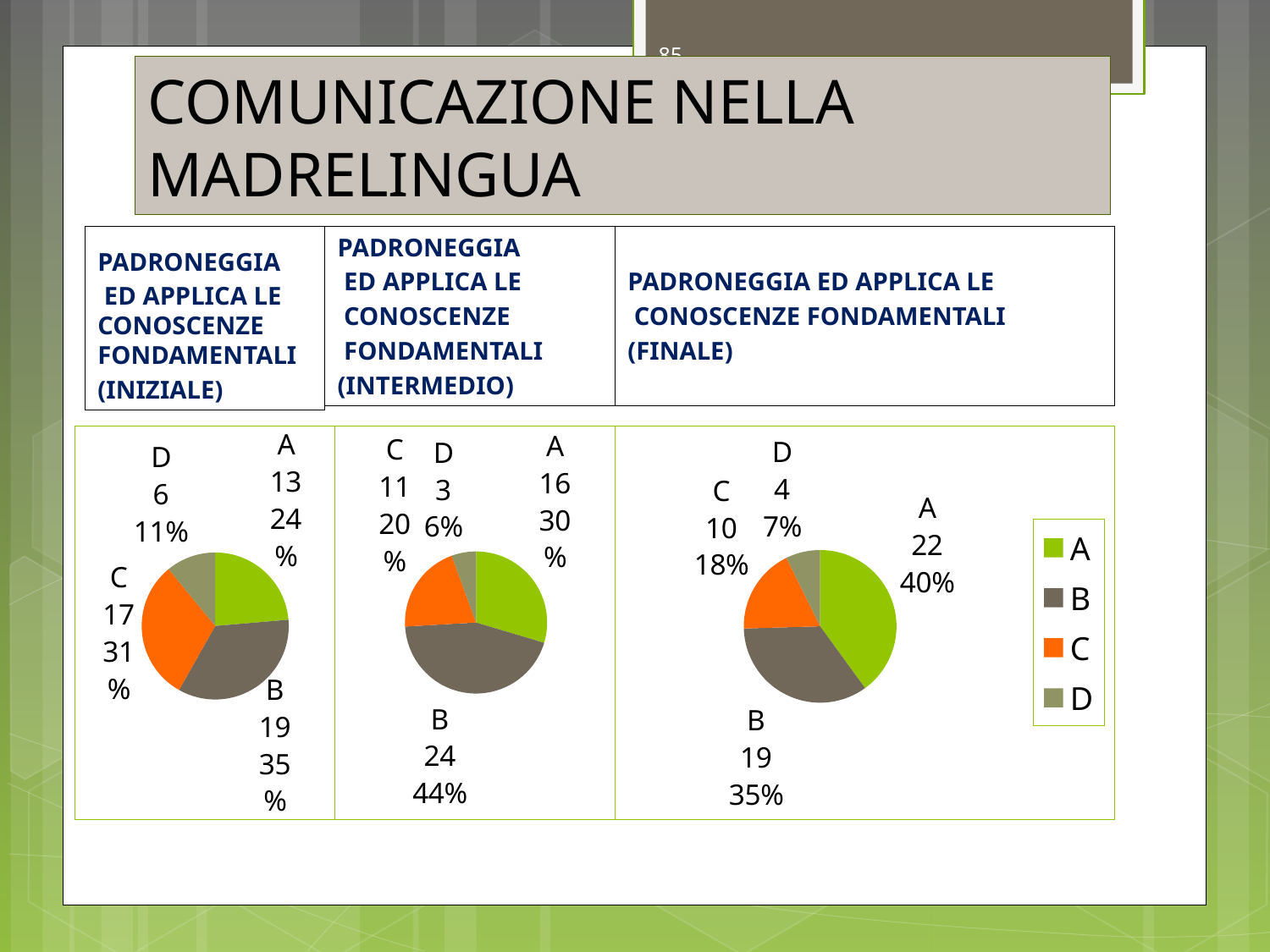
In the INTERMEDIO pie chart (middle), which category has the smallest slice? D How many categories does each pie chart on the slide show? 4 In the FINALE pie chart (right), what is the value for category D? 4 How many entries does the legend on the right of the slide list? 4 In the INIZIALE pie chart (left), which is larger, the value for B or the value for C? B In the FINALE pie chart (right), what percentage share does category A have? 40% What type of chart is used for the three charts on the slide? Pie chart In the INIZIALE pie chart (left), what is the value for category B? 19 In the INTERMEDIO pie chart (middle), which category has the largest slice? B In the FINALE pie chart (right), what is the difference between the values for A and B? 3 In the INTERMEDIO pie chart (middle), what is the value for category A? 16 In the INIZIALE pie chart (left), what percentage share does category C have? 31%